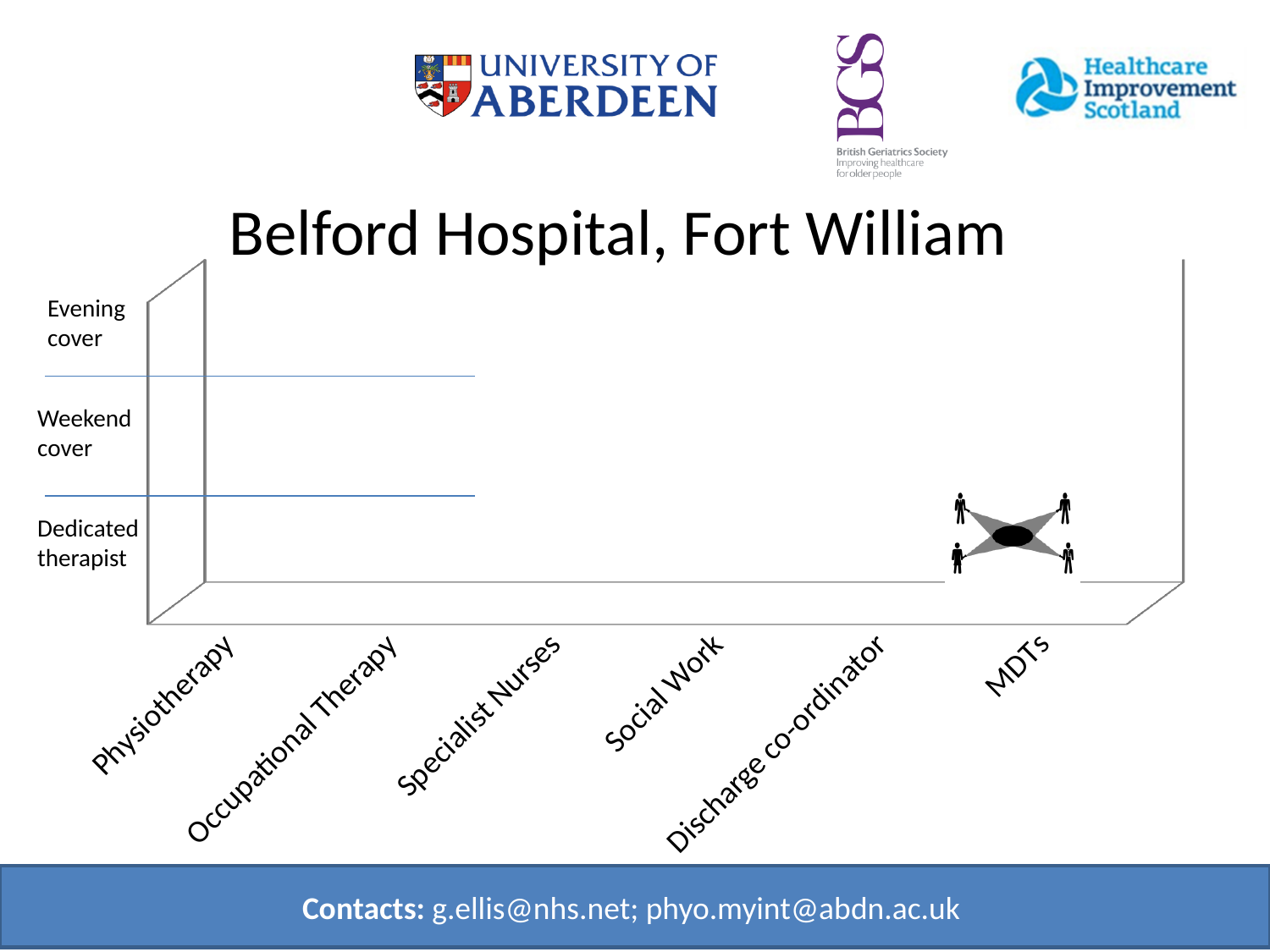
What kind of chart is shown on the slide? bar chart What is the lowest level labelled on the y axis? Dedicated therapist Which category is labelled first (leftmost) on the x axis? Physiotherapy What is the title of the chart? Belford Hospital, Fort William How many categories are labelled along the x axis of the chart? 6 At which y-axis level is the team icon for MDTs placed? Dedicated therapist How many levels are labelled on the y axis of the chart? 3